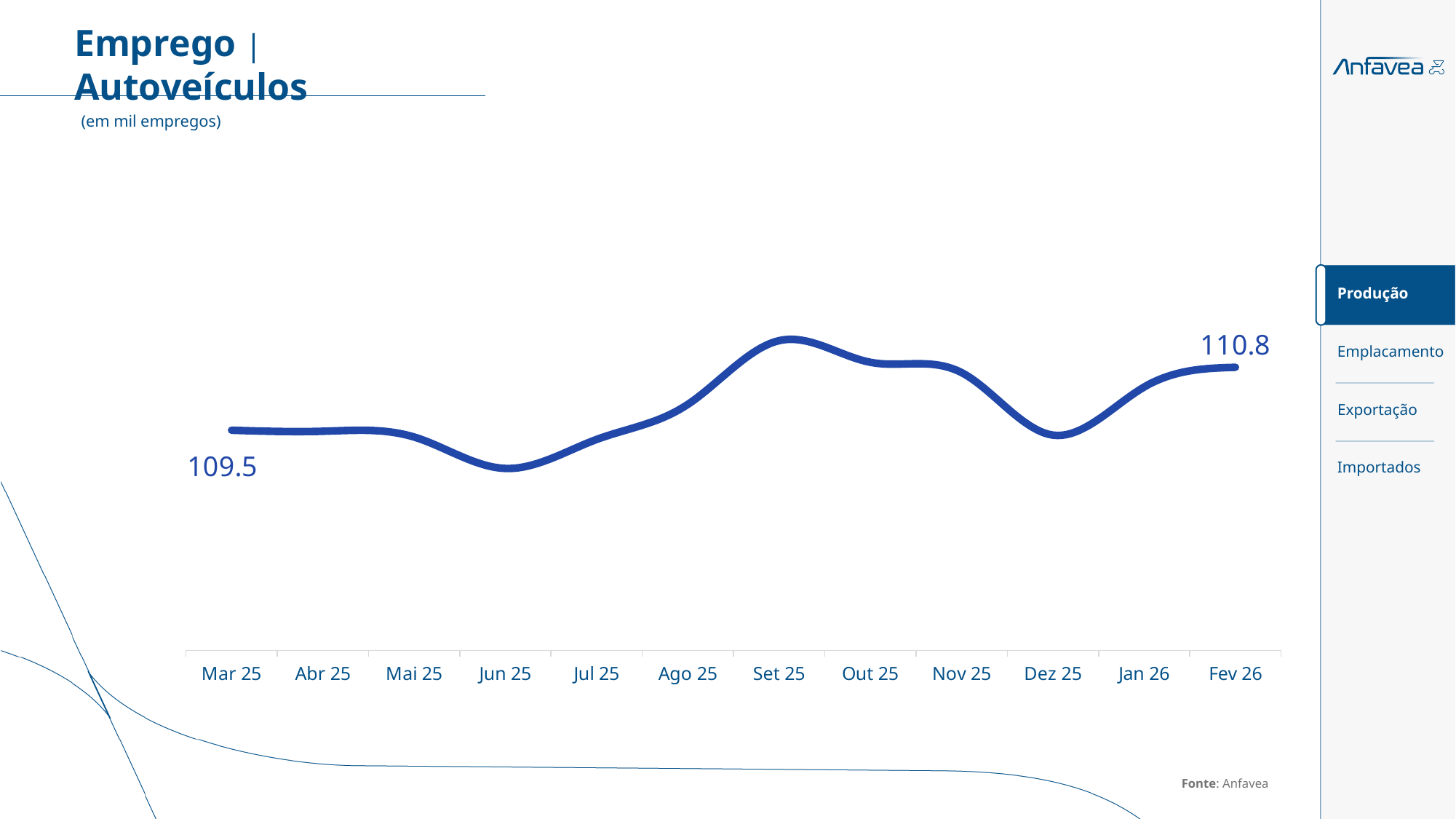
How many months are shown on the x axis? 12 In what unit are the values expressed, according to the subtitle? em mil empregos What is the value for Mar 25? 109.5 Which month has the lowest value on the line? Jun 25 Which month has the highest value on the line? Set 25 Overall, does the value rise or fall from Mar 25 to Fev 26? Rise What is the difference between the values for Fev 26 and Mar 25? 1.3 Which is larger, the value for Fev 26 or the value for Dez 25? Fev 26 Which is larger, the value for Set 25 or the value for Mar 25? Set 25 What is the value for Fev 26? 110.8 What is the title of the chart? Emprego | Autoveículos What kind of chart is shown on the slide? Line chart